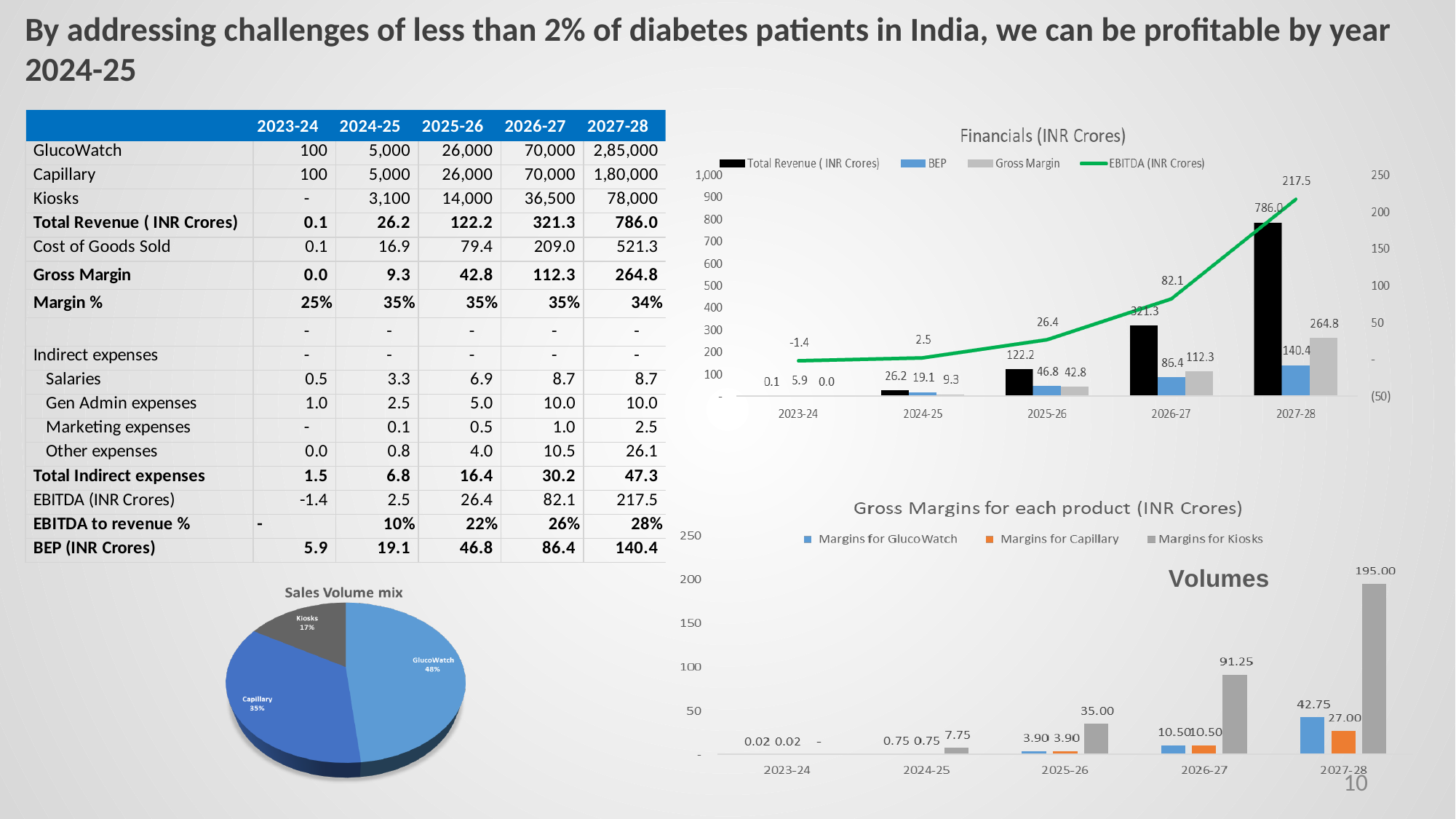
In the Gross Margins for each product chart, what is the difference between Margins for Kiosks and Margins for GlucoWatch in 2026-27? 80.75 In the Gross Margins for each product chart, what is the margin for Kiosks in 2027-28? 195.00 In the Gross Margins for each product chart, which is larger in 2027-28: Margins for GlucoWatch or Margins for Capillary? Margins for GlucoWatch In the Financials (INR Crores) chart, what is the Total Revenue for 2027-28? 786.0 In the Financials (INR Crores) chart, what is the BEP value for 2026-27? 86.4 In the Sales Volume mix pie chart, which product has the largest share? GlucoWatch In the Financials (INR Crores) chart, what is the difference between Total Revenue and Gross Margin in 2027-28? 521.2 In the Sales Volume mix pie chart, how many slices are there? 3 In the Financials (INR Crores) chart, how many series does the legend list? 4 In the Financials (INR Crores) chart, does the EBITDA line rise or fall from 2023-24 to 2027-28? rises In the Financials (INR Crores) chart, what is the EBITDA value for 2023-24? -1.4 In the Sales Volume mix pie chart, what share does Capillary have? 35%